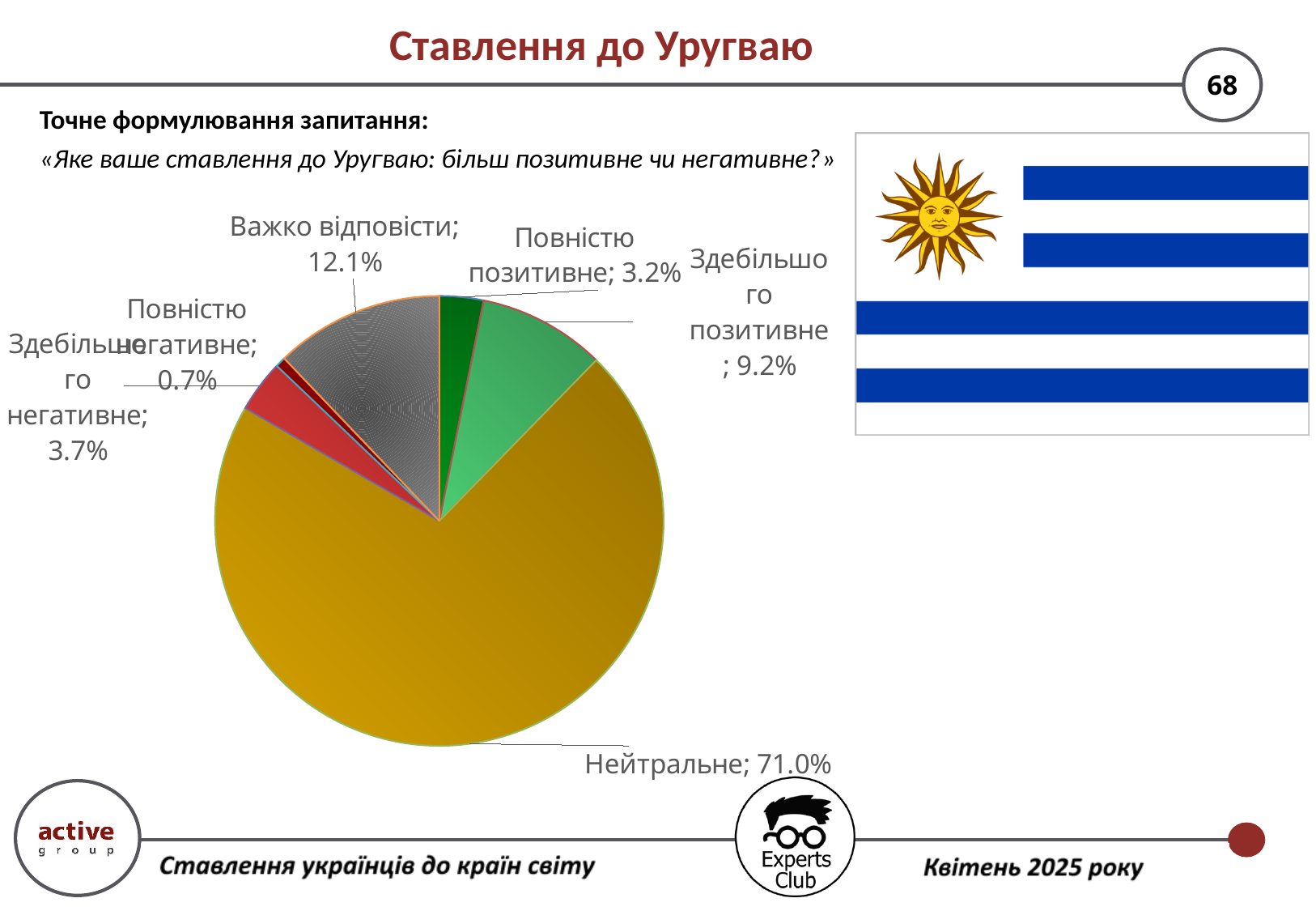
What is the combined share of "Повністю позитивне" and "Здебільшого позитивне"? 12.4% Which category has the smallest slice of the pie? Повністю негативне What percentage is shown for "Важко відповісти"? 12.1% Which category has the largest slice of the pie? Нейтральне Which is larger: "Здебільшого негативне" or "Повністю позитивне"? Здебільшого негативне What type of chart is shown on the slide? Pie chart What is the difference between "Здебільшого позитивне" and "Повністю позитивне"? 6.0% What share of respondents answered "Нейтральне" in the pie chart? 71.0% How many categories are shown in the pie chart? 6 What is the value for "Здебільшого позитивне"? 9.2% What percentage is labelled for "Повністю негативне"? 0.7% What is the title of the slide containing the chart? Ставлення до Уругваю